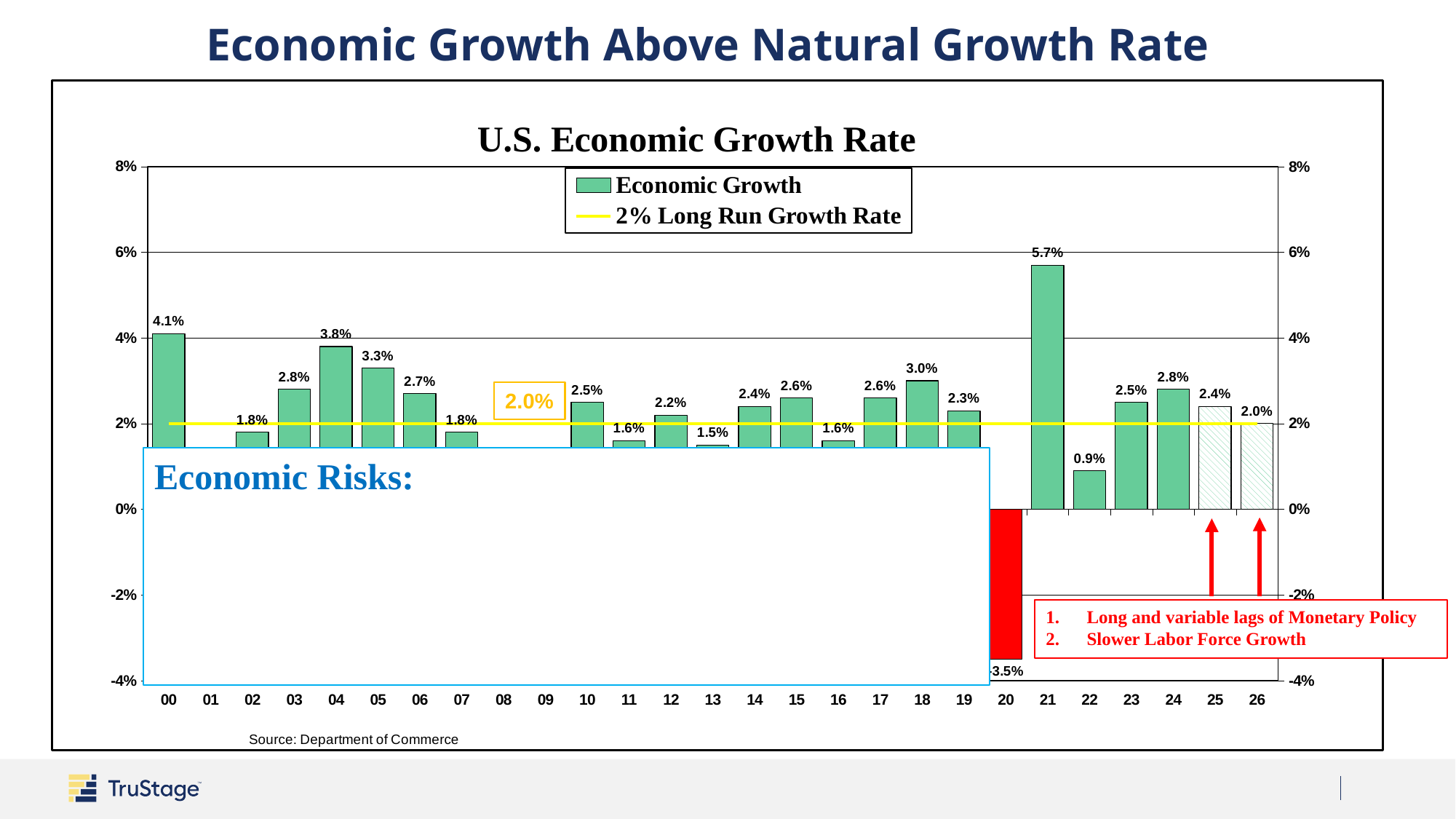
How many series does the legend list? 2 Which year had the higher growth rate, 04 or 05? 04 What is the projected economic growth rate for 2026 (labelled 26)? 2.0% What is the economic growth rate shown for 2000 (labelled 00)? 4.1% Which year has the lowest economic growth rate on the chart? 20 What is the source cited for the chart data? Department of Commerce Which year has the highest economic growth rate on the chart? 21 What is the economic growth rate shown for 2021 (labelled 21)? 5.7% What is the economic growth rate shown for 2020 (labelled 20)? -3.5% What kind of chart is used to show the U.S. Economic Growth Rate? Bar chart Is the value for 2022 (labelled 22) greater or less than 2%? less What is the difference between the growth rate in 2021 (5.7%) and 2018 (3.0%)? 2.7 percentage points